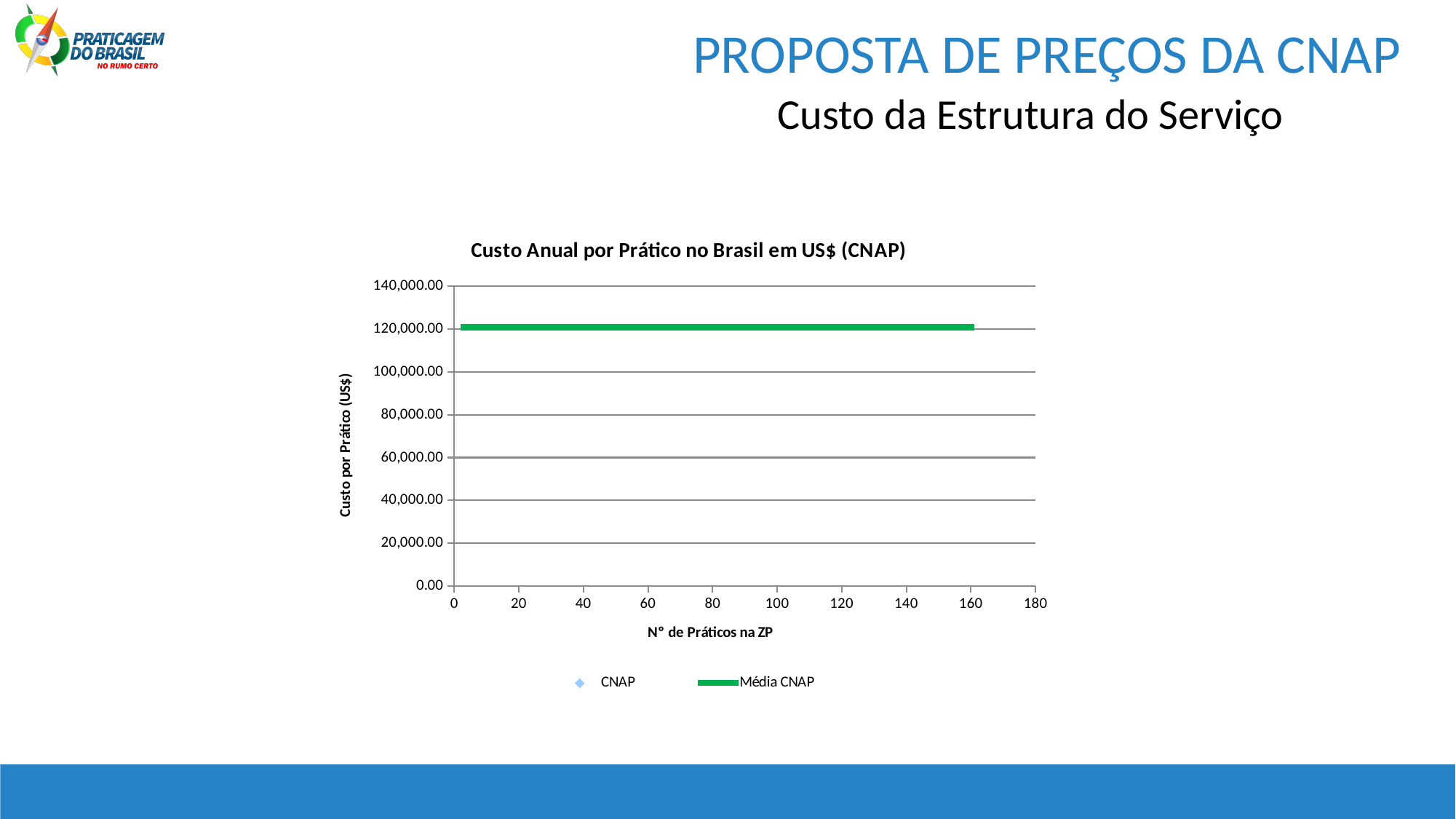
How many series does the chart legend list? 2 What is the label of the x axis? N° de Práticos na ZP What is the label of the y axis? Custo por Prático (US$) What is the title of the chart? Custo Anual por Prático no Brasil em US$ (CNAP) Is the value of the Média CNAP line greater or less than 80,000.00? greater Does the Média CNAP line rise, fall, or stay flat as the number of práticos increases along the x axis? stays flat Is the value of the Média CNAP line greater or less than 100,000.00? greater Is the value of the Média CNAP line greater or less than 140,000.00? less